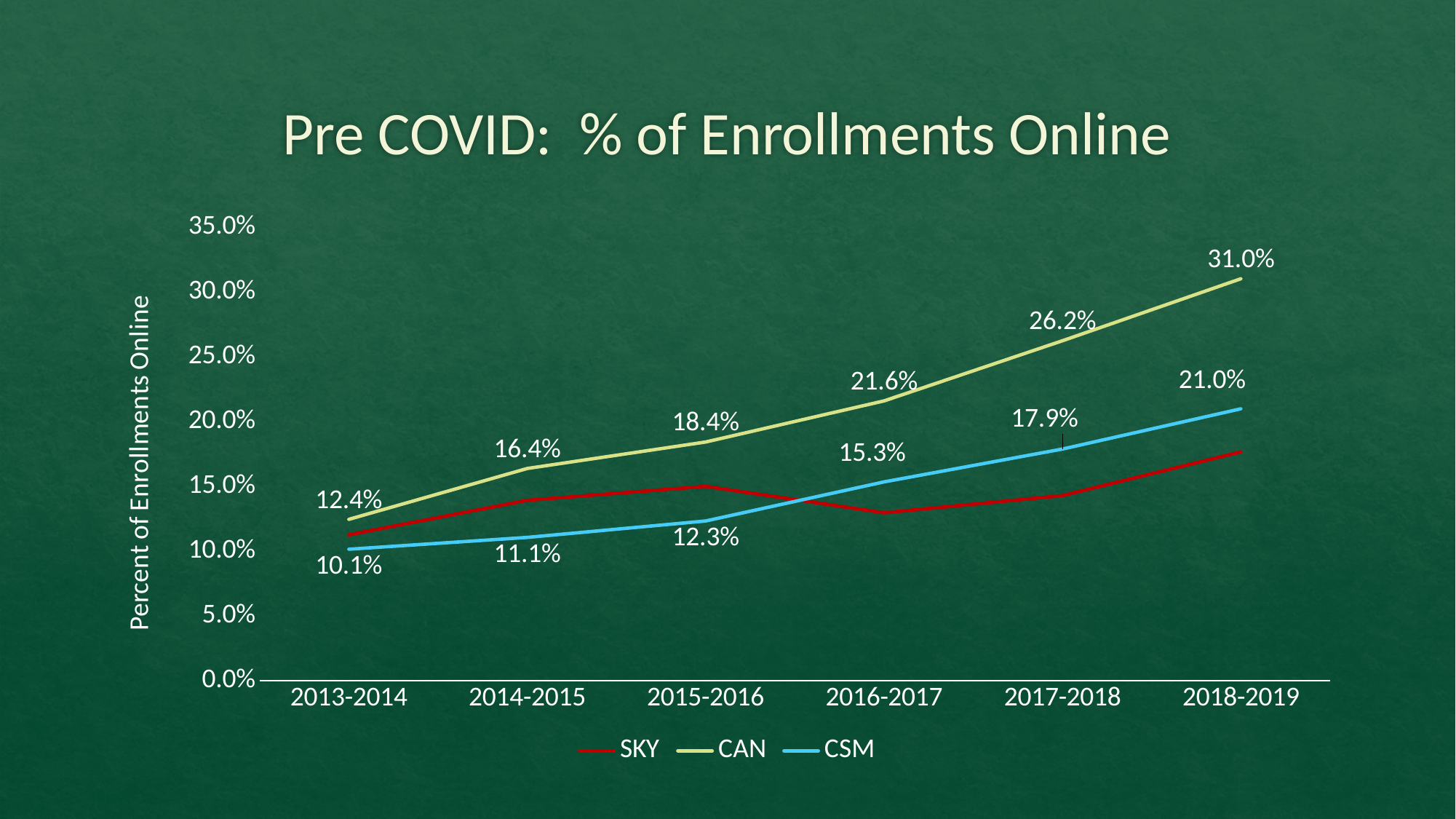
In which academic year is the CAN series highest? 2018-2019 What is the difference between CAN and CSM in 2018-2019? 10.0% Is the value for SKY in 2018-2019 greater or less than 20.0%? less What is the value for CAN in 2015-2016? 18.4% What kind of chart is shown on the slide? line chart Which series has the larger value in 2016-2017, CAN or CSM? CAN In which academic year is the CSM series lowest? 2013-2014 What is the value for CSM in 2013-2014? 10.1% What is the value for CAN in 2018-2019? 31.0% Does the CAN series rise or fall from 2013-2014 to 2018-2019? rise How many series does the legend list? 3 How many academic years are shown on the x axis? 6